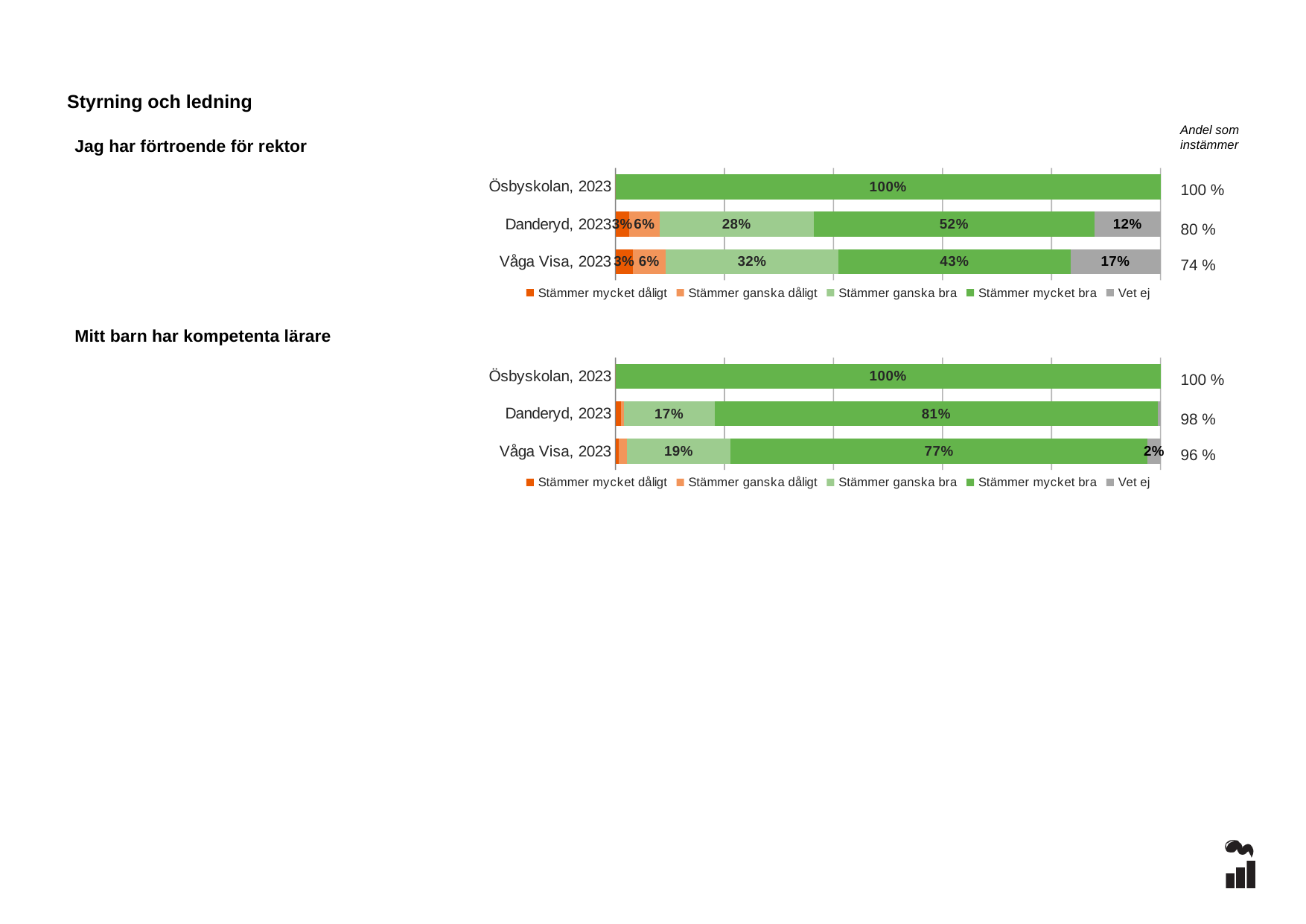
In the chart 'Jag har förtroende för rektor', what is the difference between the 'Stämmer mycket bra' values for Danderyd, 2023 and Våga Visa, 2023? 9% What kind of chart is 'Mitt barn har kompetenta lärare'? Stacked bar chart In the chart 'Jag har förtroende för rektor', what is the value for 'Stämmer ganska bra' for Våga Visa, 2023? 32% In the chart 'Jag har förtroende för rektor', what is the value for 'Vet ej' for Våga Visa, 2023? 17% In the chart 'Mitt barn har kompetenta lärare', which is larger: 'Stämmer mycket bra' for Danderyd, 2023 or for Våga Visa, 2023? Danderyd, 2023 In the chart 'Mitt barn har kompetenta lärare', what is the 'Andel som instämmer' value shown for Danderyd, 2023? 98 % In the chart 'Mitt barn har kompetenta lärare', what is the value for 'Stämmer mycket bra' for Danderyd, 2023? 81% How many series does the legend of the chart 'Jag har förtroende för rektor' list? 5 In the chart 'Mitt barn har kompetenta lärare', what is the value for 'Stämmer ganska bra' for Våga Visa, 2023? 19% In the chart 'Jag har förtroende för rektor', which category has the highest value for 'Stämmer mycket bra'? Ösbyskolan, 2023 In the chart 'Jag har förtroende för rektor', what is the 'Andel som instämmer' value shown for Våga Visa, 2023? 74 % In the chart 'Jag har förtroende för rektor', what is the value for 'Stämmer mycket bra' for Danderyd, 2023? 52%